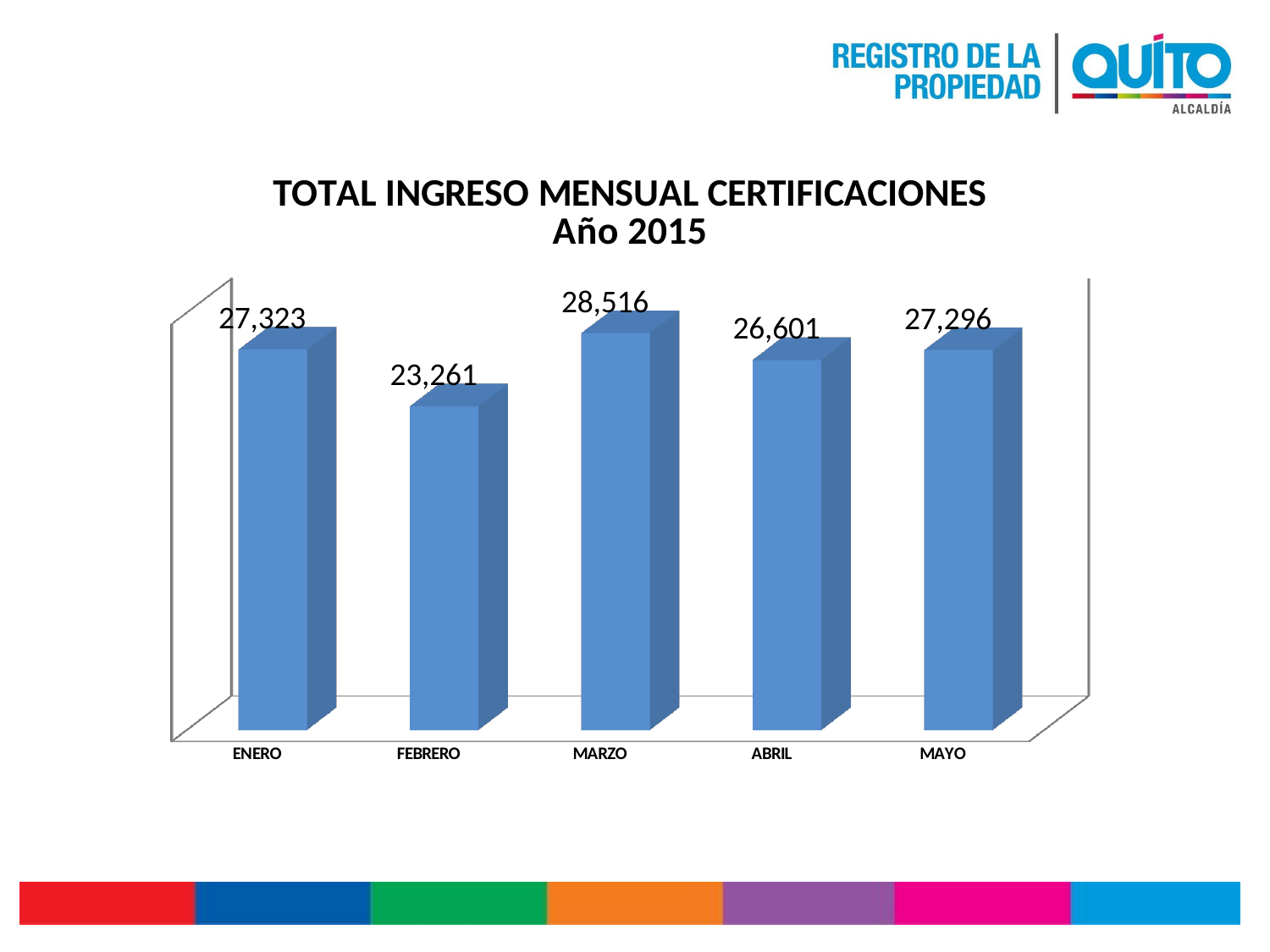
What is the value for ENERO? 27,323 Which month has the highest value? MARZO Which is larger, the value for ENERO or the value for FEBRERO? ENERO What is the value for ABRIL? 26,601 What is the difference between the values for MARZO and FEBRERO? 5,255 What is the value for MAYO? 27,296 How many months are shown on the chart? 5 What is the value for MARZO? 28,516 What is the title of the chart? TOTAL INGRESO MENSUAL CERTIFICACIONES Año 2015 Which month has the lowest value? FEBRERO What kind of chart is shown on the slide? Bar chart What is the value for FEBRERO? 23,261